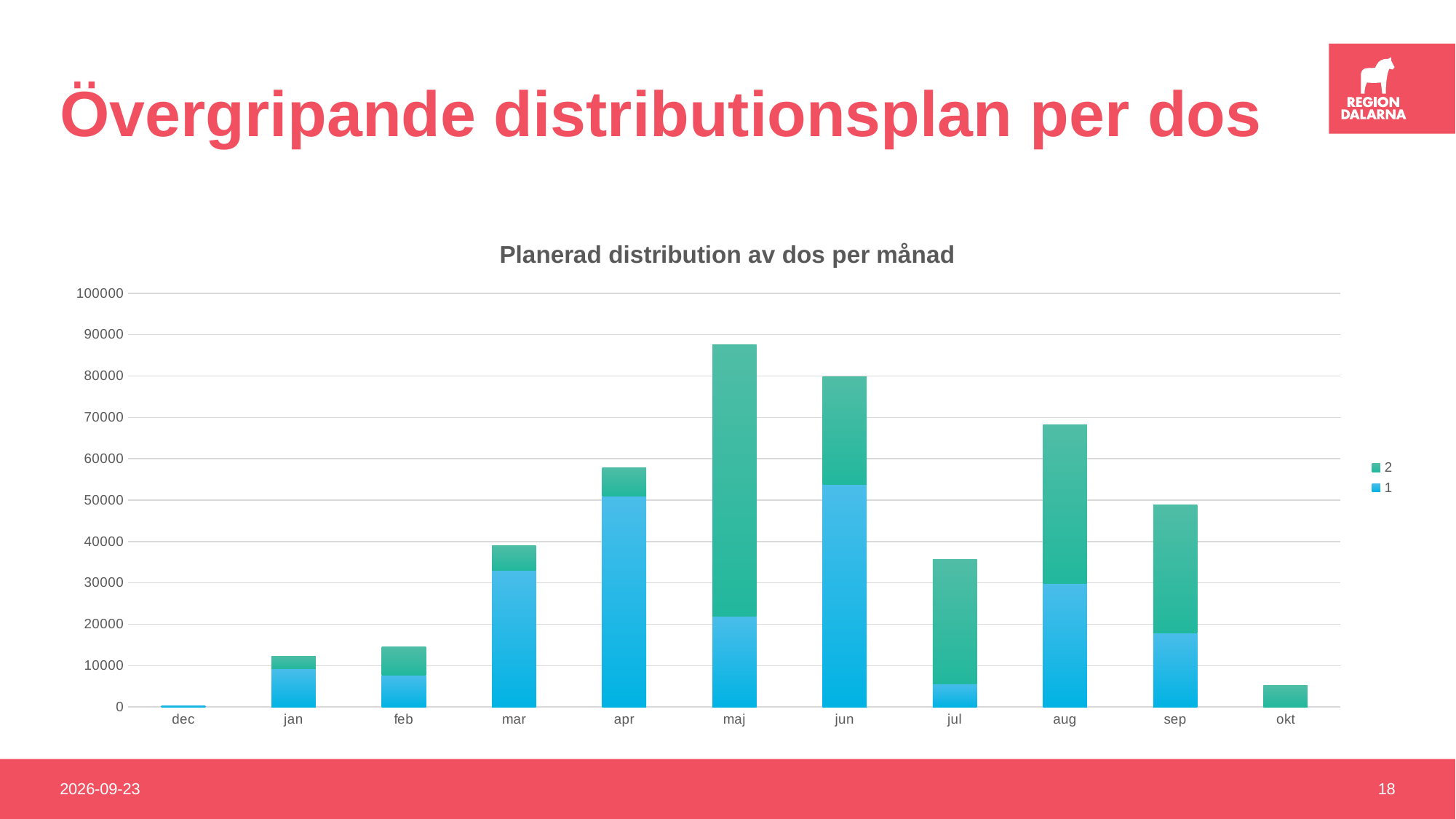
Which month has a higher total bar, mar or sep? sep Is the value of series 1 for jun greater or less than 50000? greater Which month has the highest total planned distribution? maj Is the total value for aug greater or less than 60000? greater What kind of chart is shown on the slide? stacked bar chart Is the total value for jul greater or less than 40000? less Which month has the lowest total planned distribution? dec How many series does the legend list? 2 What is the title of the chart? Planerad distribution av dos per månad Which month has a higher total bar, maj or jun? maj How many months are shown on the x axis? 11